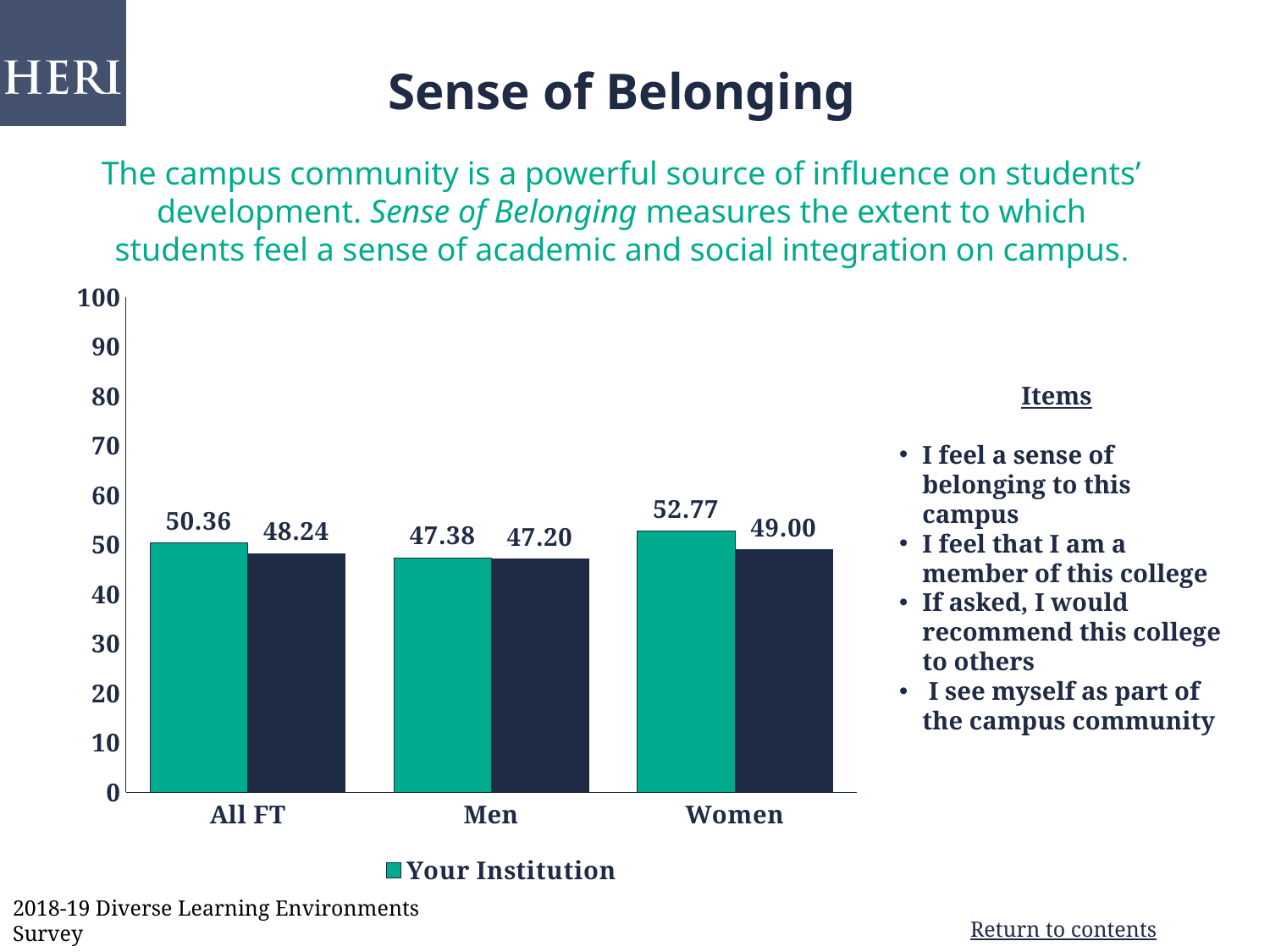
What is the difference between the Your Institution bar and the dark navy bar for All FT? 2.12 How many categories are shown on the x axis? 3 What is the Your Institution value for Women? 52.77 Which category has the highest Your Institution value? Women What is the difference between the Your Institution bar and the dark navy bar for Women? 3.77 Which category has the lowest Your Institution value? Men Is the Your Institution value for Men greater or less than 50? less What is the value of the dark navy bar for Women? 49.00 What is the value of the dark navy bar for All FT? 48.24 Which is larger, the Your Institution value for All FT or for Women? Women What is the Your Institution value for Men? 47.38 What kind of chart is shown on the slide? bar chart